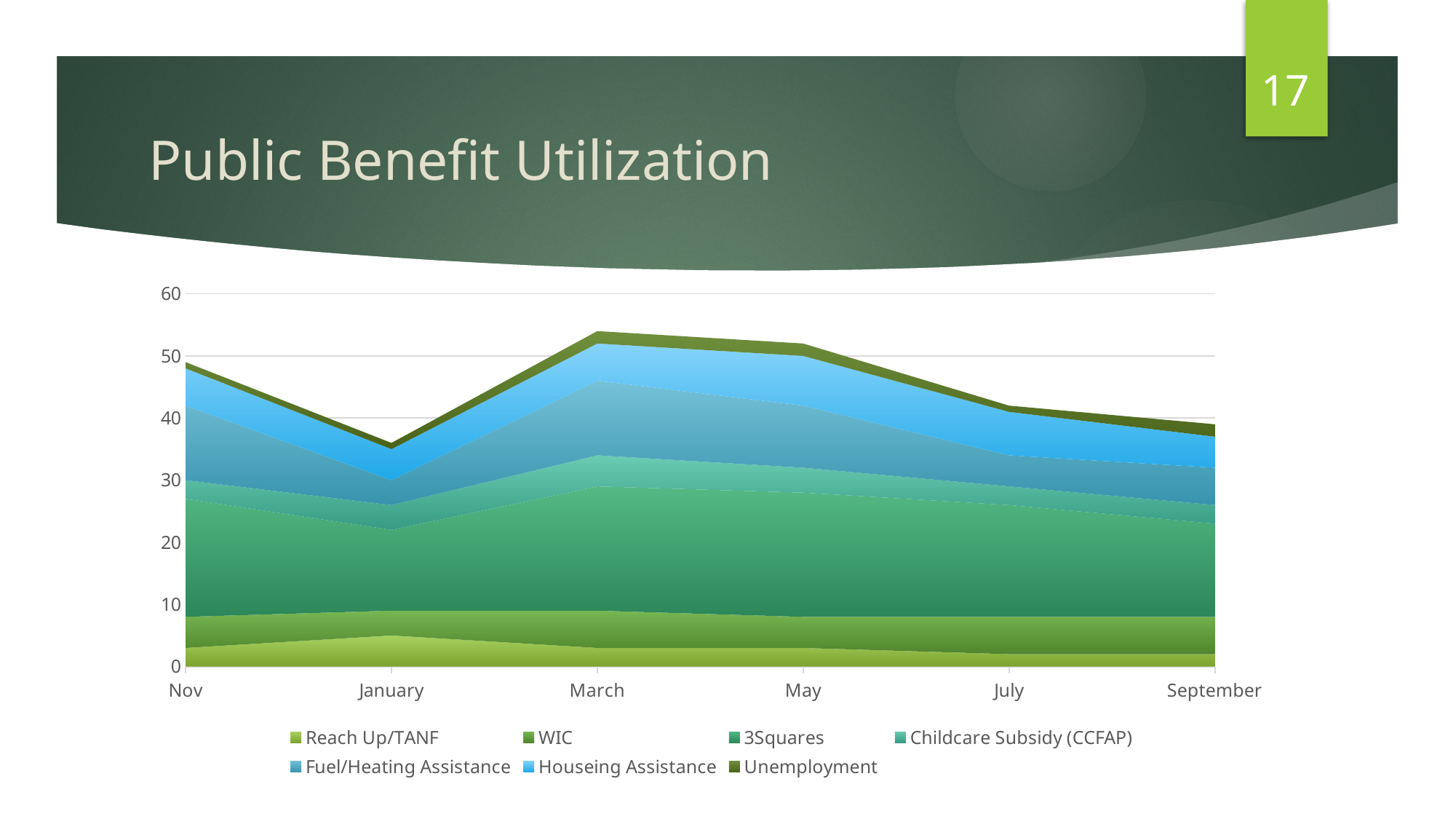
In which month is the total stacked value highest? March What is the title of the slide containing the chart? Public Benefit Utilization What kind of chart is shown on the slide? stacked area chart Is the total stacked value for January greater or less than 40? less From March to September, does the total stacked value rise or fall? fall How many series does the legend list? 7 Is the total stacked value for March greater or less than 50? greater Is the total stacked value for July greater or less than 40? greater How many months are labelled along the x axis? 6 In which month is the total stacked value lowest? January Which series is listed first in the legend? Reach Up/TANF Which month has the larger total stacked value, March or January? March